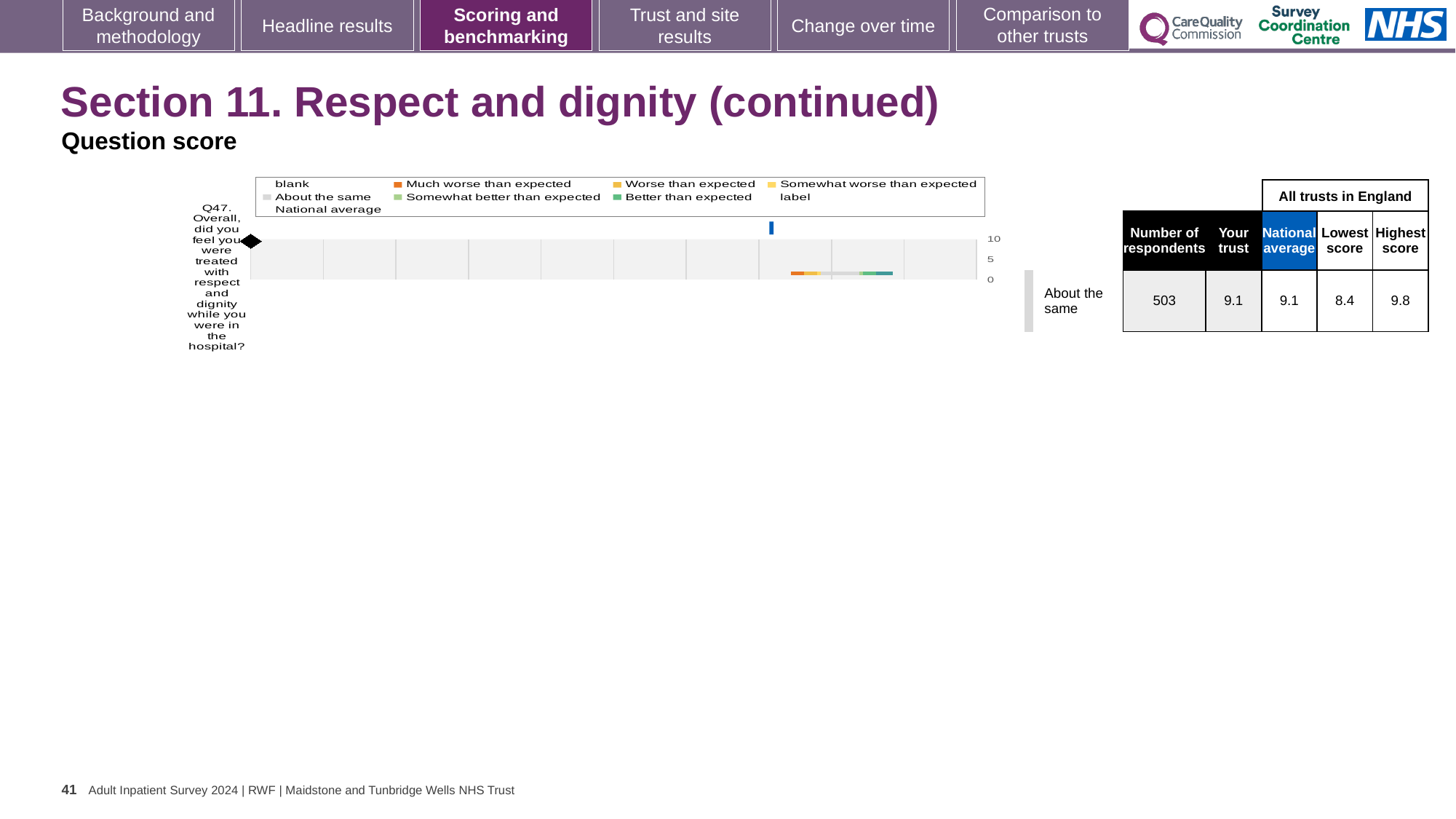
According to the table beside the chart, what is the lowest score among all trusts in England for Q47? 8.4 Which question is plotted on the chart? Q47. Overall, did you feel you were treated with respect and dignity while you were in the hospital? What is the highest value shown on the chart's axis? 10 How many respondents answered Q47, according to the table beside the chart? 503 How many questions (categories) are plotted on the chart? 1 What kind of chart is shown on the slide? bar chart How many entries does the chart legend list? 9 According to the table beside the chart, what is the highest score among all trusts in England for Q47? 9.8 According to the table beside the chart, what is the 'Your trust' score for Q47? 9.1 What is the difference between the highest score and the lowest score for Q47 in the table beside the chart? 1.4 According to the table beside the chart, what is the national average score for Q47? 9.1